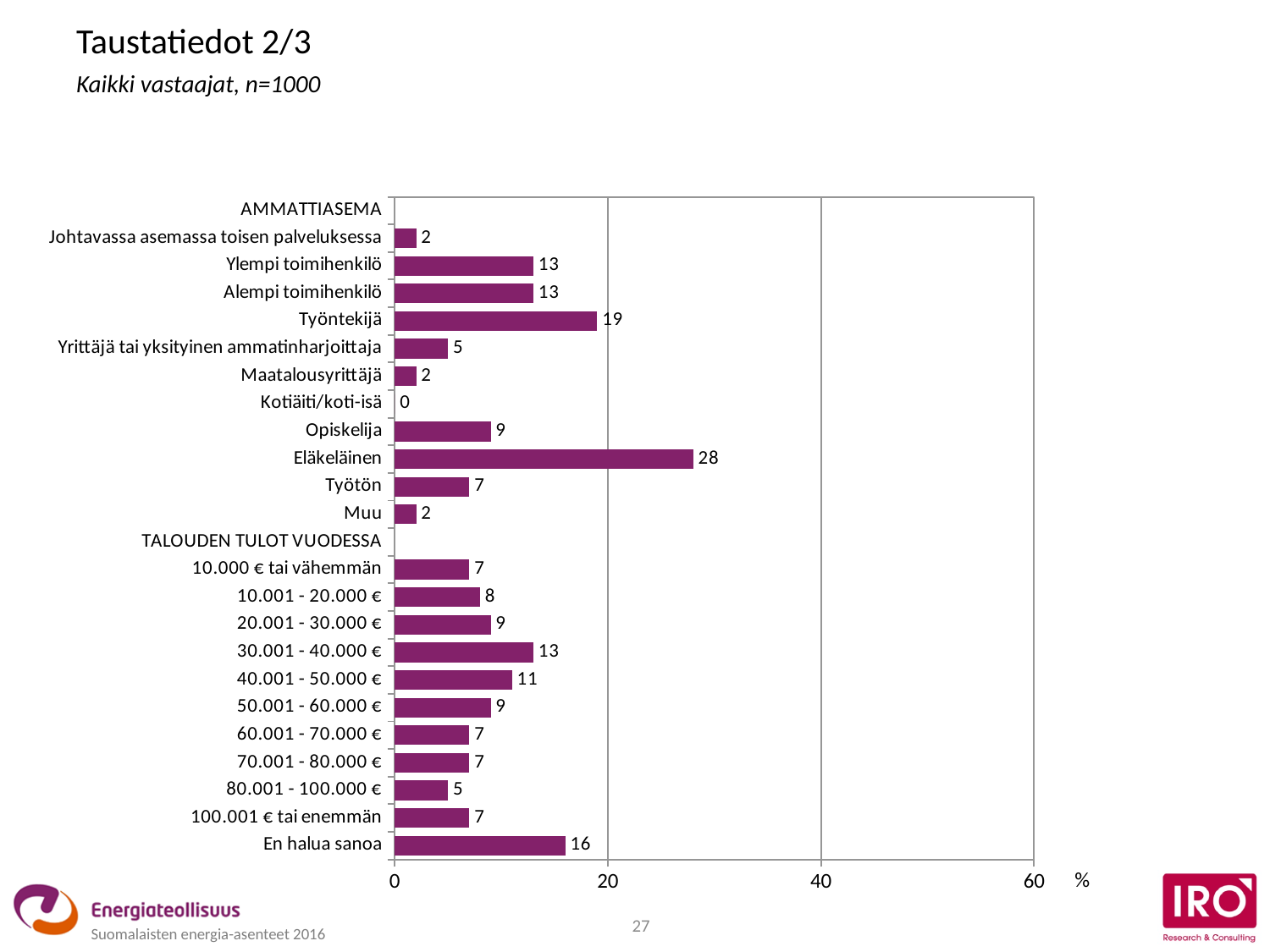
What is the value for Eläkeläinen? 28 What is the difference between the values for Eläkeläinen and Työntekijä? 9 Which is larger, the value for Opiskelija or the value for Työtön? Opiskelija What unit is shown at the end of the x axis? % Which category has the lowest value on the chart? Kotiäiti/koti-isä Is the value for Eläkeläinen greater or less than 20? greater What is the difference between the values for 30.001 - 40.000 € and 80.001 - 100.000 €? 8 Which category has the highest value on the chart? Eläkeläinen What is the value for 40.001 - 50.000 €? 11 What is the value for En halua sanoa? 16 What kind of chart is shown on the slide? bar chart What is the value for Työntekijä? 19